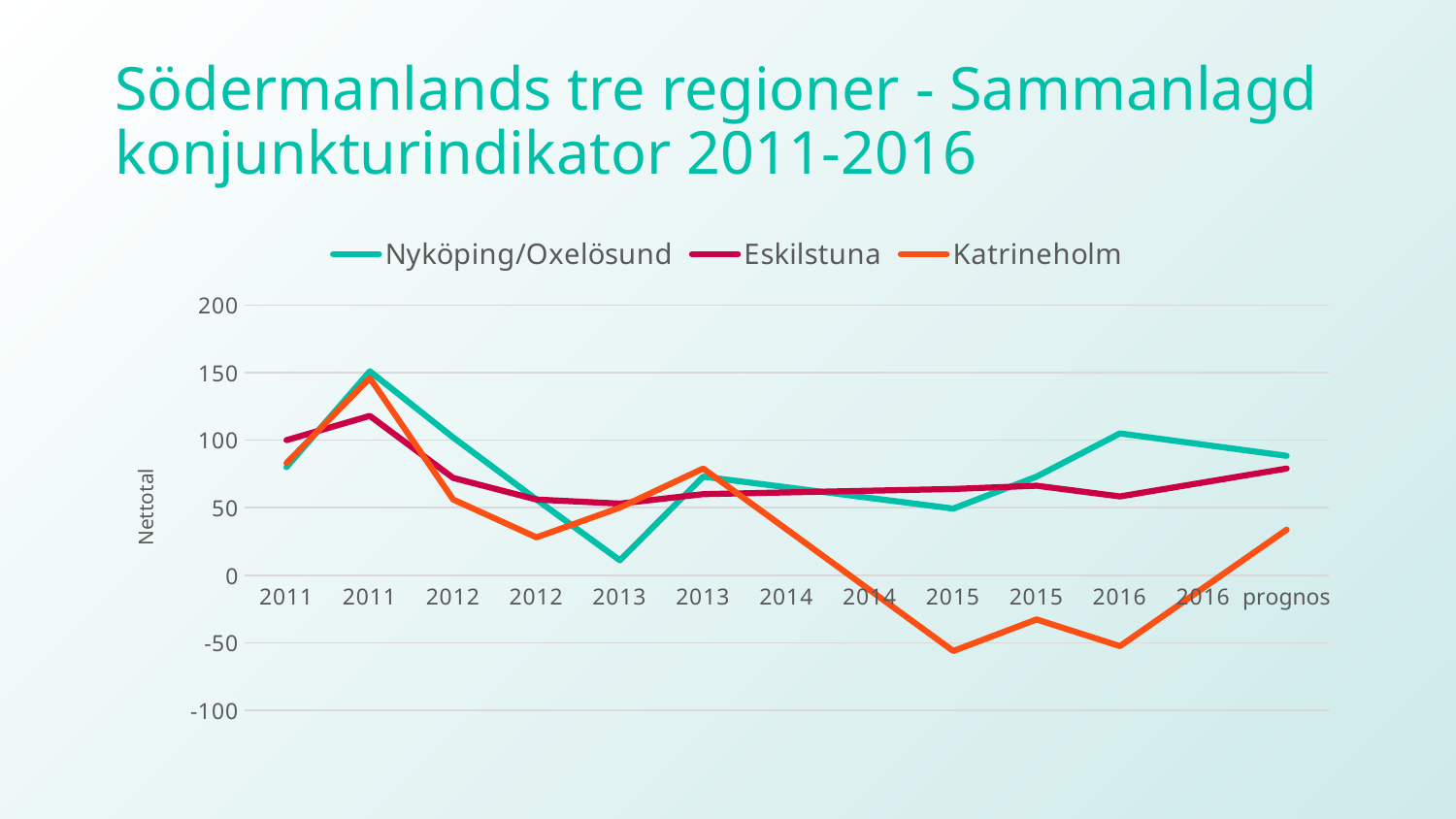
At the 2016 prognos point, which is larger: Nyköping/Oxelösund or Katrineholm? Nyköping/Oxelösund What kind of chart is shown on the slide? line chart How many series does the legend list? 3 What is the label of the vertical axis? Nettotal Does the Katrineholm line rise or fall from the second 2013 point to the first 2015 point? fall Which series is drawn in orange? Katrineholm How many points are plotted along the x axis for each series? 13 Is the value for Nyköping/Oxelösund at the second 2011 point greater or less than 100? greater Is the value for Nyköping/Oxelösund at the first 2013 point greater or less than 50? less Which series reaches the lowest value anywhere on the chart? Katrineholm Which series reaches the highest value anywhere on the chart? Nyköping/Oxelösund Is the value for Katrineholm at the first 2015 point greater or less than 0? less